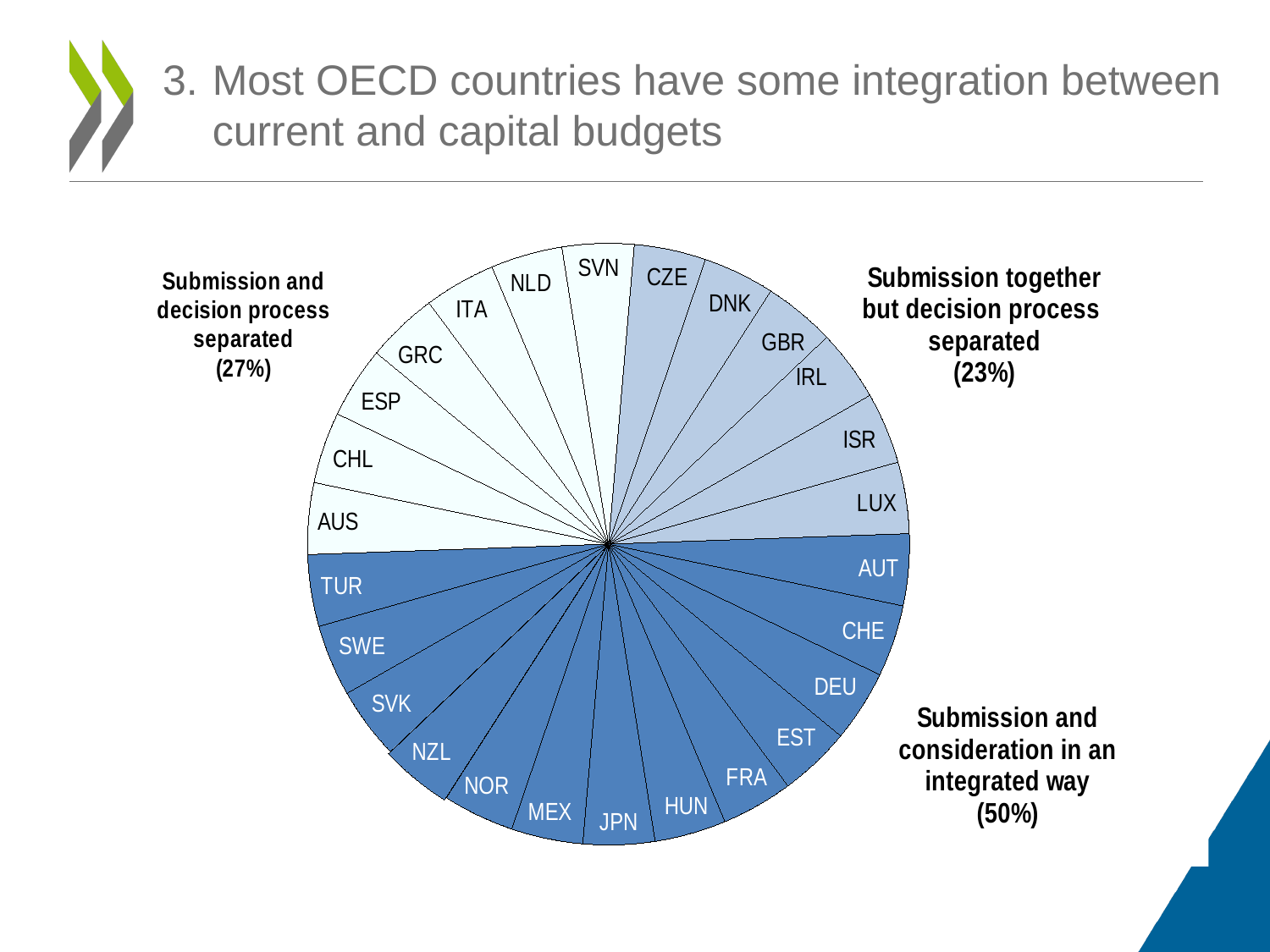
How many countries are in the "Submission and consideration in an integrated way" group? 13 How many country slices are in the pie chart in total? 26 Which group has the larger share: "Submission and decision process separated" or "Submission together but decision process separated"? Submission and decision process separated Which of the three groups has the largest share of the pie? Submission and consideration in an integrated way Which group does the AUS slice belong to? Submission and decision process separated What is the difference in percentage points between the "integrated way" group (50%) and the "submission and decision process separated" group (27%)? 23 Which of the three groups has the smallest share of the pie? Submission together but decision process separated What kind of chart is shown on the slide? pie chart What is the difference in percentage points between the "submission and decision process separated" group and the "submission together but decision process separated" group? 4 What share of the pie is labelled "Submission and consideration in an integrated way"? 50% What share of the pie is labelled "Submission and decision process separated"? 27% What share of the pie is labelled "Submission together but decision process separated"? 23%